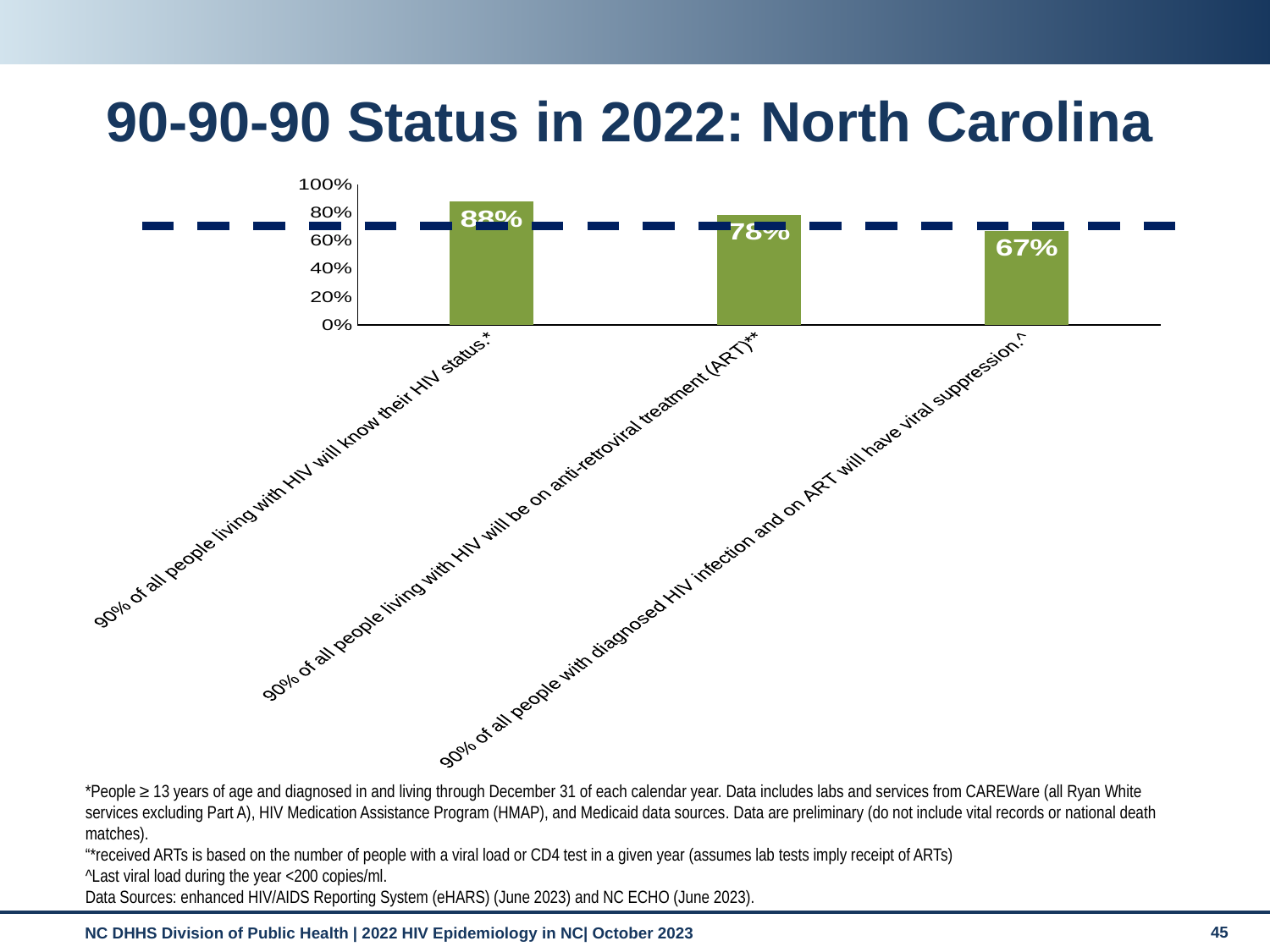
What is the difference between the value for knowing HIV status and the value for being on ART? 10% What is the value for '90% of all people with diagnosed HIV infection and on ART will have viral suppression'? 67% How many bars are plotted in the chart? 3 Which category has the highest value? 90% of all people living with HIV will know their HIV status What is the value for '90% of all people living with HIV will know their HIV status'? 88% Do the values rise or fall from left to right across the chart? fall Which is larger: the value for being on ART or the value for viral suppression? being on ART Which category has the lowest value? 90% of all people with diagnosed HIV infection and on ART will have viral suppression What kind of chart is shown on the slide? bar chart What is the difference between the value for knowing HIV status and the value for viral suppression? 21% What is the value for '90% of all people living with HIV will be on anti-retroviral treatment (ART)'? 78% What is the title of the slide containing the chart? 90-90-90 Status in 2022: North Carolina